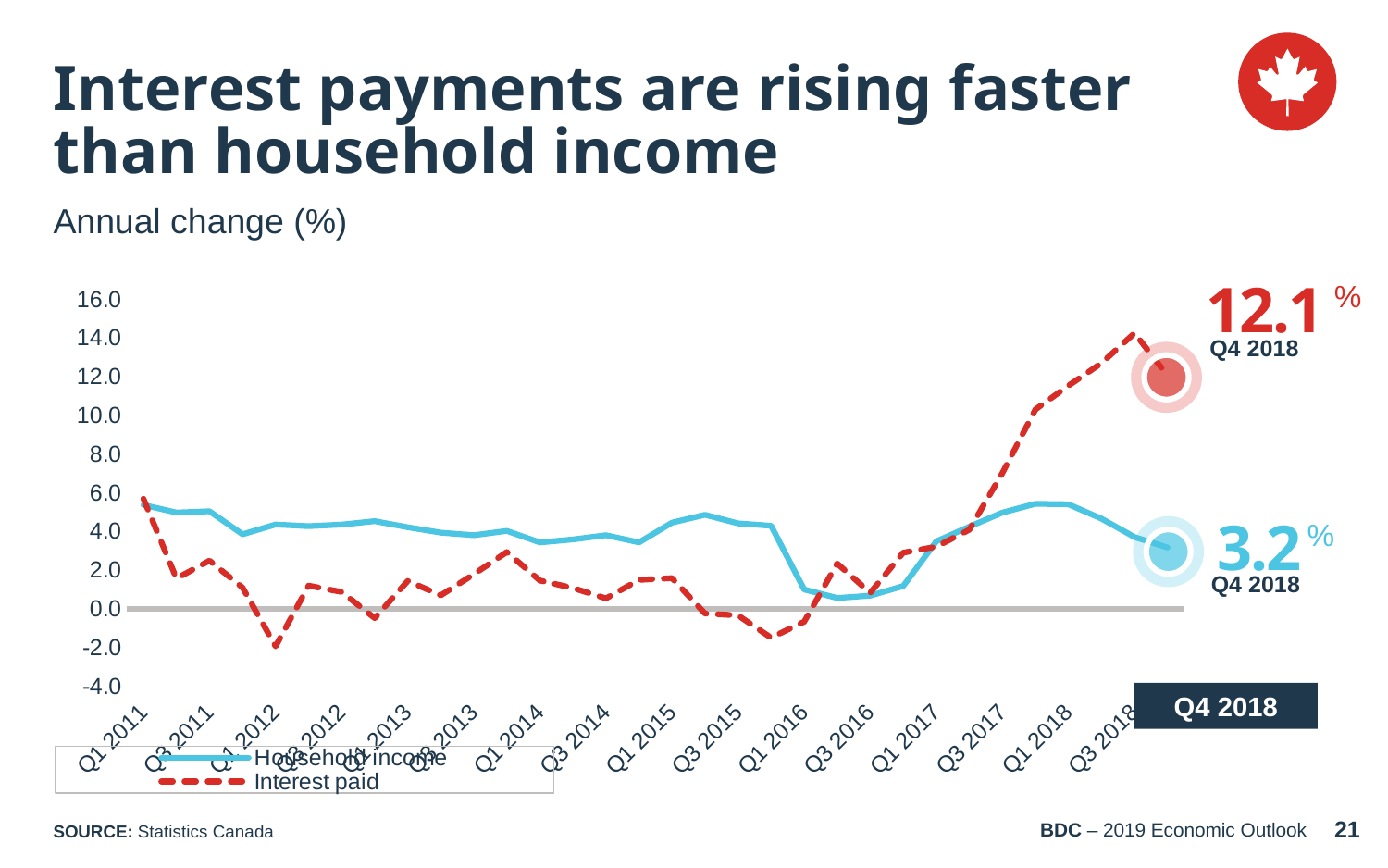
What kind of chart is shown on the slide? Line chart Which series reaches the highest value on the chart? Interest paid What is the difference between the Interest paid and Household income values in Q4 2018? 8.9 percentage points Does the Interest paid series rise or fall between Q1 2017 and Q4 2018? Rises What is the value for Household income in Q4 2018? 3.2% Is the value for Interest paid in Q1 2018 greater or less than 8.0? greater How many series does the legend list? 2 In Q4 2018, which series has the larger value, Interest paid or Household income? Interest paid Is the value for Interest paid in Q1 2012 greater or less than 0.0? less Is the value for Household income in Q1 2016 greater or less than 2.0? less What line style and colour is used for the Interest paid series? Red dashed line What is the value for Interest paid in Q4 2018? 12.1%